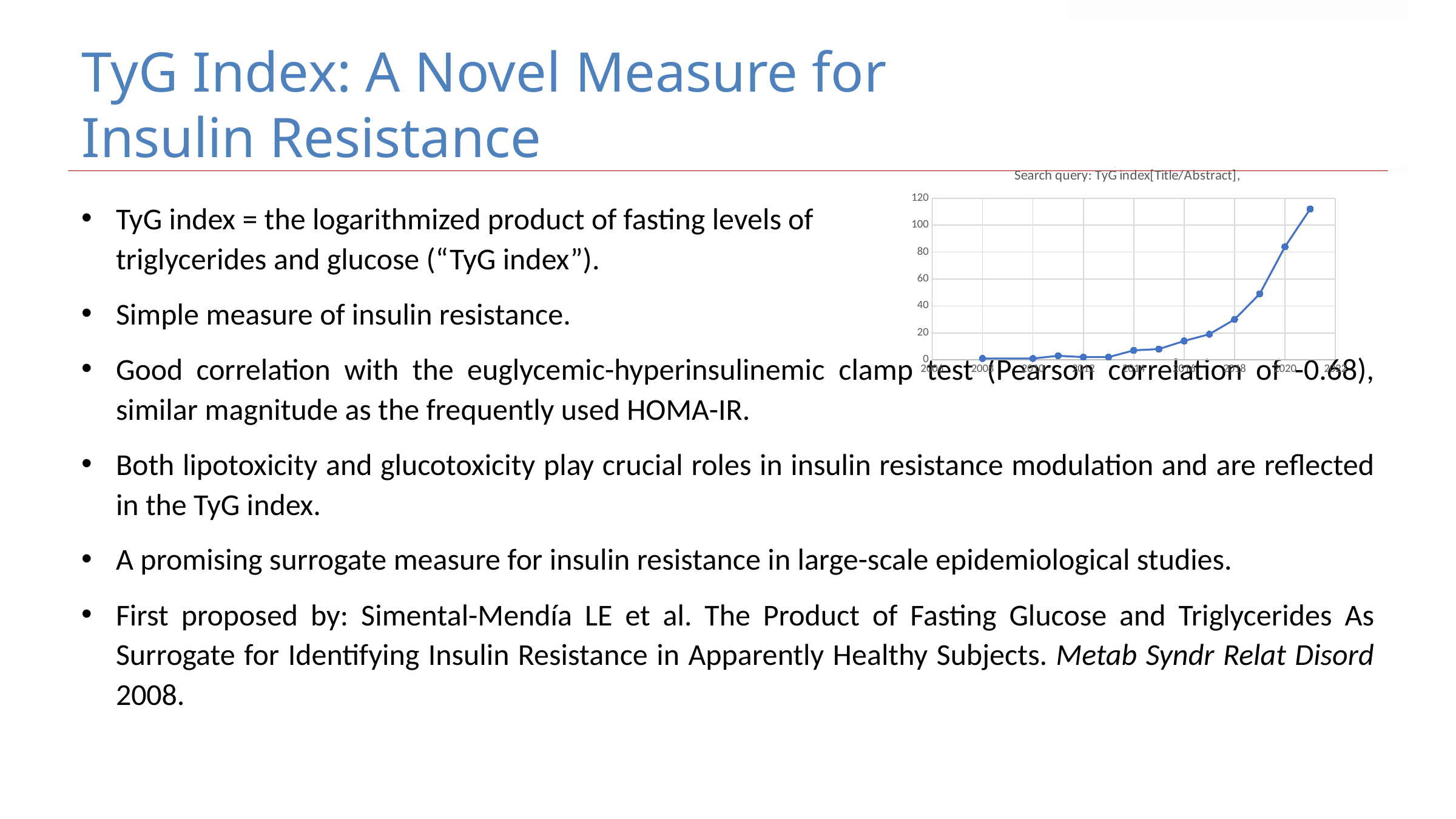
What kind of chart is shown on the slide? line chart Which year has the larger value, 2014 or 2018? 2018 Is the value for 2020 greater or less than 60? greater What is the highest tick value shown on the chart's vertical axis? 120 Is the value for 2012 greater or less than 20? less Do the values in the chart generally rise or fall from left to right along the x axis? rise Is the highest point in the chart greater or less than 100? greater Which year has the larger value, 2016 or 2020? 2020 What search query is named in the chart's title? TyG index[Title/Abstract]